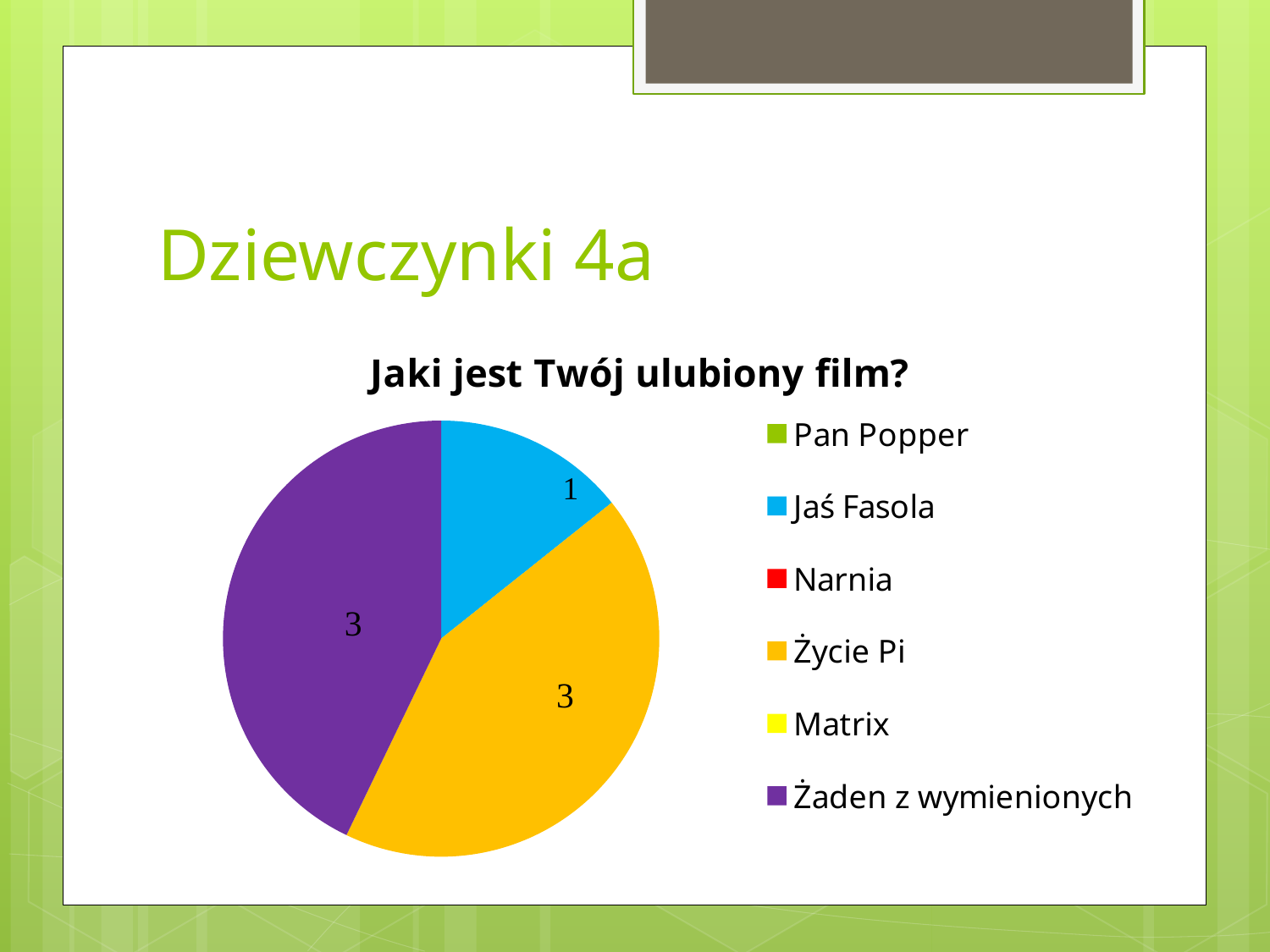
Which is larger, the value for Życie Pi or the value for Jaś Fasola? Życie Pi How many slices with data labels are visible in the pie? 3 What is the total of all the labelled values in the pie? 7 What is the difference between the value for Życie Pi and the value for Jaś Fasola? 2 What value is shown for Życie Pi? 3 What value is shown for Żaden z wymienionych? 3 What is the title of the chart? Jaki jest Twój ulubiony film? How many entries does the legend list? 6 What value is shown for Jaś Fasola? 1 What colour is used for Narnia in the legend? red Which of the labelled slices has the smallest value? Jaś Fasola What type of chart is shown on the slide? pie chart